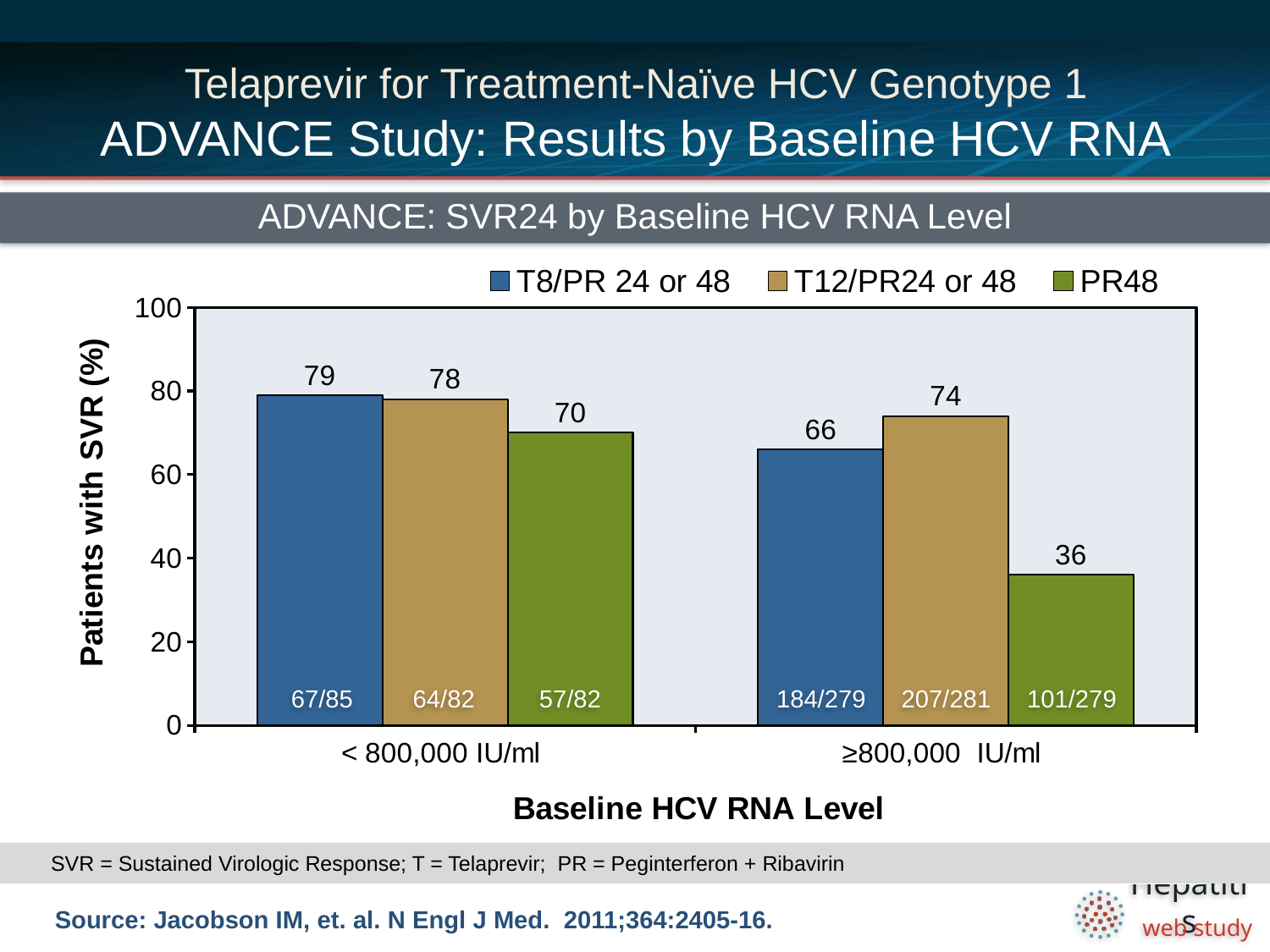
Which treatment arm has the lowest SVR rate in the ≥800,000 IU/ml group? PR48 What is the SVR rate for T8/PR 24 or 48 in the < 800,000 IU/ml group? 79 How many baseline HCV RNA level categories are shown on the x axis? 2 What fraction is printed inside the T12/PR24 or 48 bar for the ≥800,000 IU/ml group? 207/281 What is the SVR rate for T12/PR24 or 48 in the ≥800,000 IU/ml group? 74 How many series does the legend list? 3 What is the SVR rate for PR48 in the ≥800,000 IU/ml group? 36 Which treatment arm has the highest SVR rate in the ≥800,000 IU/ml group? T12/PR24 or 48 What kind of chart is shown on the slide? Bar chart Is the SVR rate for PR48 in the ≥800,000 IU/ml group greater or less than 40? less Which is larger: the SVR rate for T8/PR 24 or 48 in the < 800,000 IU/ml group or in the ≥800,000 IU/ml group? < 800,000 IU/ml What is the difference in SVR rate between PR48 in the < 800,000 IU/ml group and PR48 in the ≥800,000 IU/ml group? 34